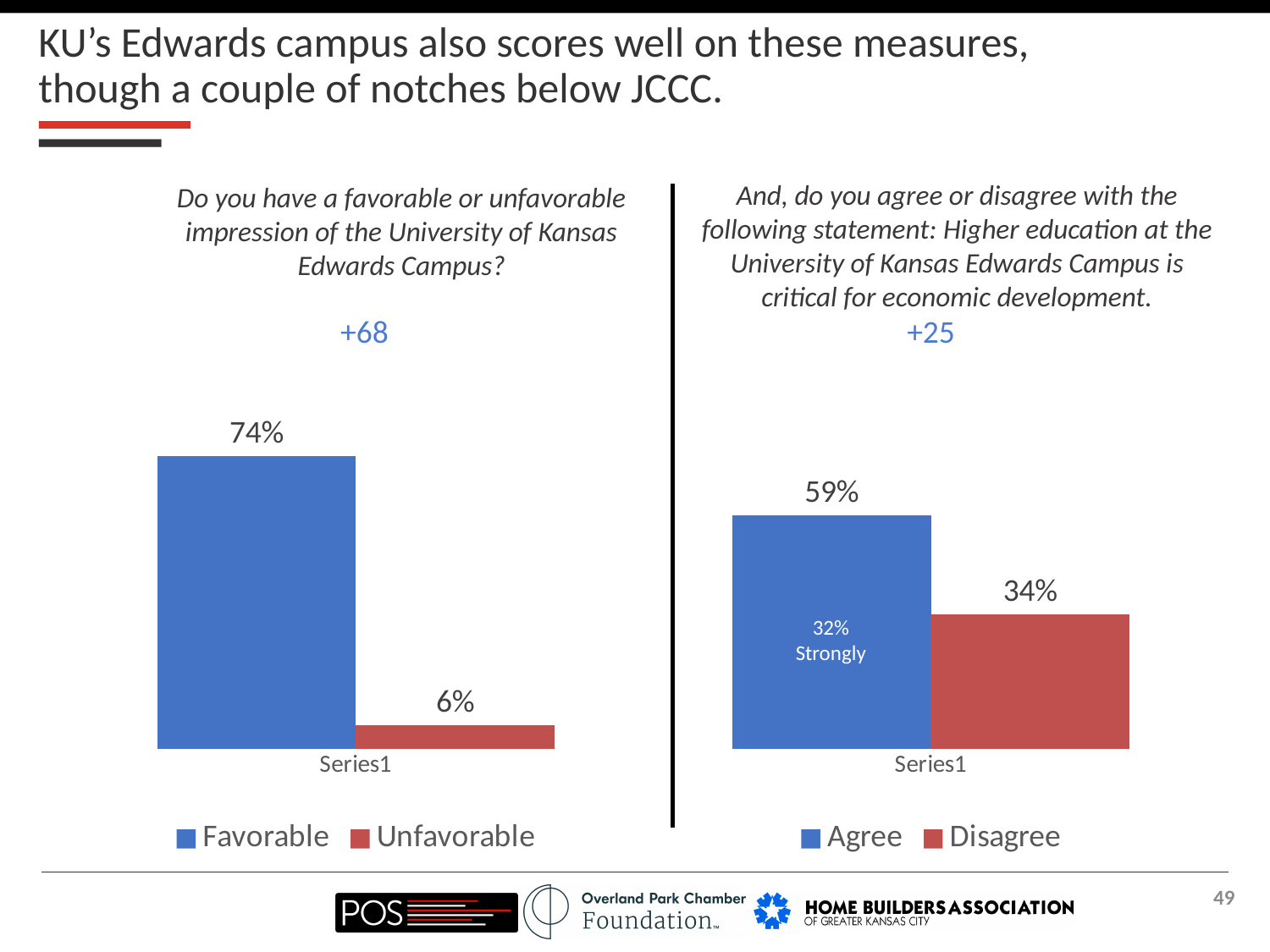
What kind of chart is the left chart? Bar chart In the left chart, which series is highest? Favorable In the right chart (higher education at KU Edwards Campus is critical for economic development), what is the value for Disagree? 34% In the right chart, which is larger, Agree or Disagree? Agree How many series does the legend of the right chart list? 2 In the right chart (higher education at KU Edwards Campus is critical for economic development), what is the value for Agree? 59% In the left chart (favorable or unfavorable impression of KU Edwards Campus), what is the value for Favorable? 74% In the left chart (favorable or unfavorable impression of KU Edwards Campus), what is the value for Unfavorable? 6% In the right chart, what share strongly agrees, as labeled inside the Agree bar? 32% In the left chart, what is the difference between Favorable and Unfavorable? 68 percentage points In the right chart, what is the difference between Agree and Disagree? 25 percentage points What net score is shown above the left chart? +68